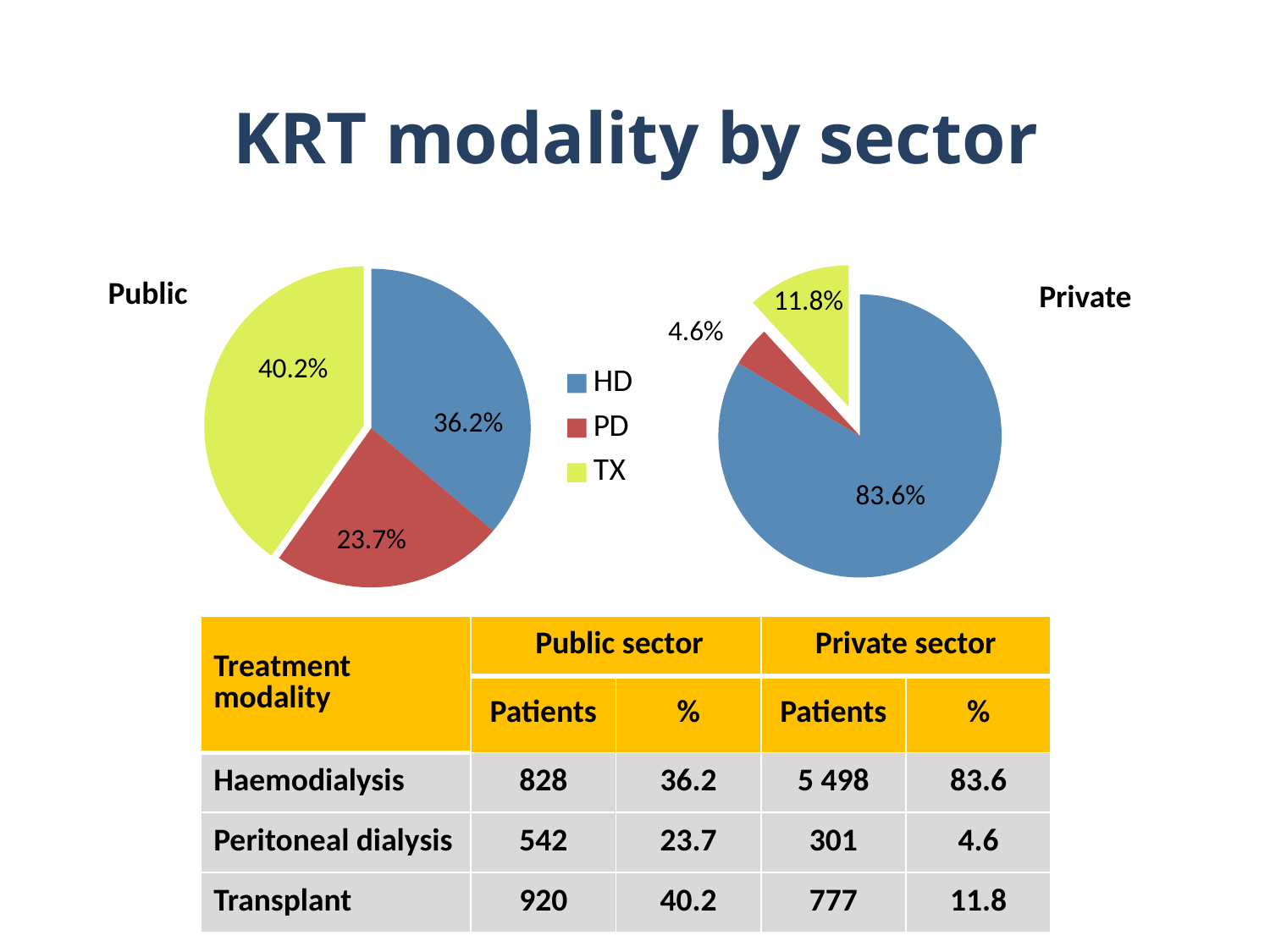
What type of chart is used for the Public sector data? Pie chart In the Private pie chart, what is the difference in percentage points between HD and TX? 71.8 In the Private pie chart, what share does PD have? 4.6% In the Public pie chart, which is larger, the HD share or the PD share? HD In the Public pie chart, what is the difference in percentage points between TX and PD? 16.5 In the Public pie chart, which modality has the smallest share? PD How many slices does the Private pie chart have? 3 In the Public pie chart, what share does HD have? 36.2% In the Public pie chart, which modality has the largest share? TX In the Public pie chart, what share does TX have? 40.2% In the Private pie chart, which modality has the smallest share? PD In the Private pie chart, what share does HD have? 83.6%